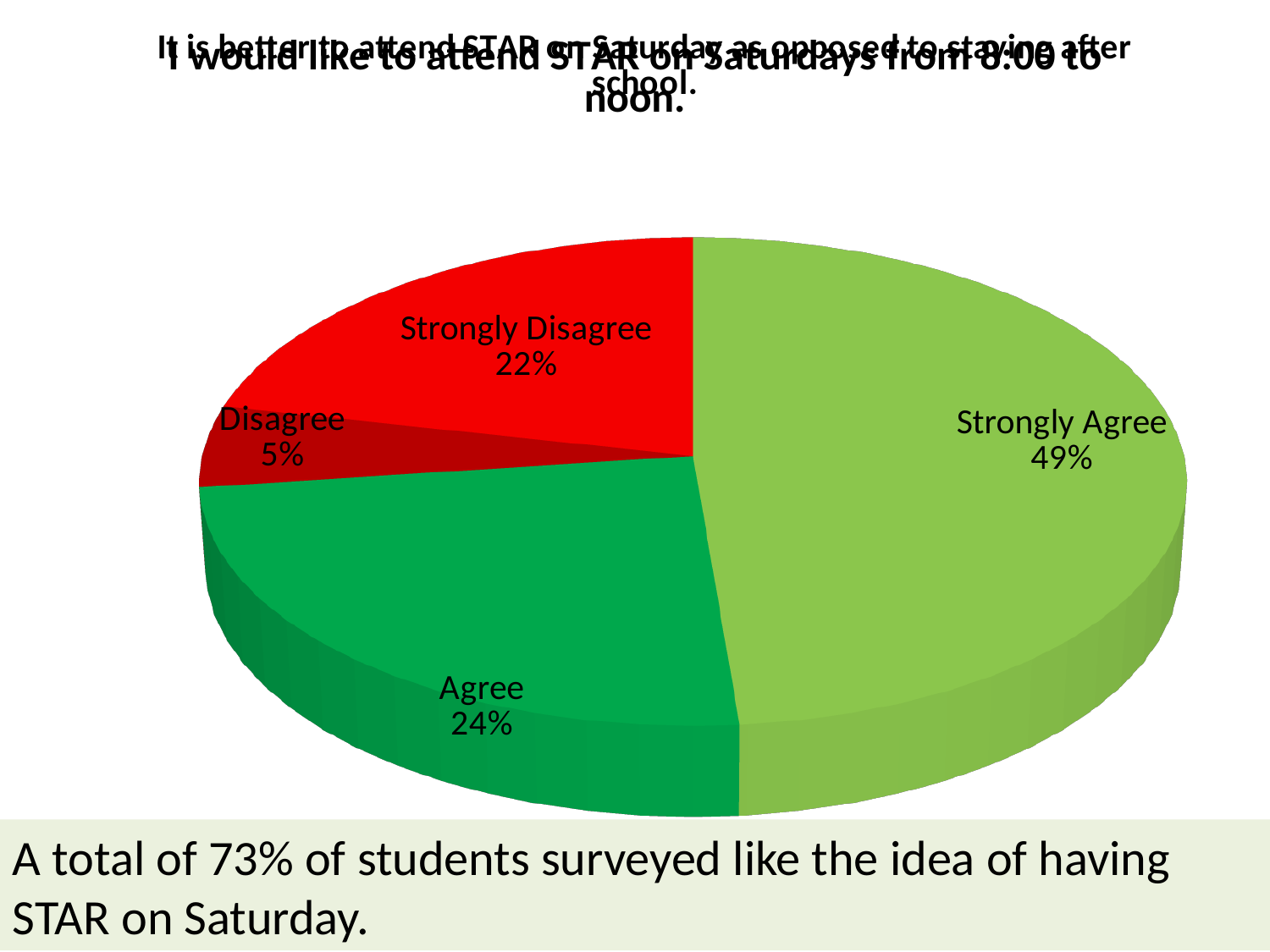
What percentage of students chose Disagree? 5% How many slices does the pie chart have? 4 Which is larger, the Agree slice or the Strongly Disagree slice? Agree Which response has the smallest share of the pie? Disagree What percentage of students chose Agree? 24% Which response has the largest share of the pie? Strongly Agree What percentage of students chose Strongly Agree? 49% What colour is the Strongly Disagree slice? red What is the difference in percentage points between Strongly Agree and Agree? 25 What is the combined share of Strongly Agree and Agree? 73% What kind of chart is shown on the slide? pie chart What percentage of students chose Strongly Disagree? 22%